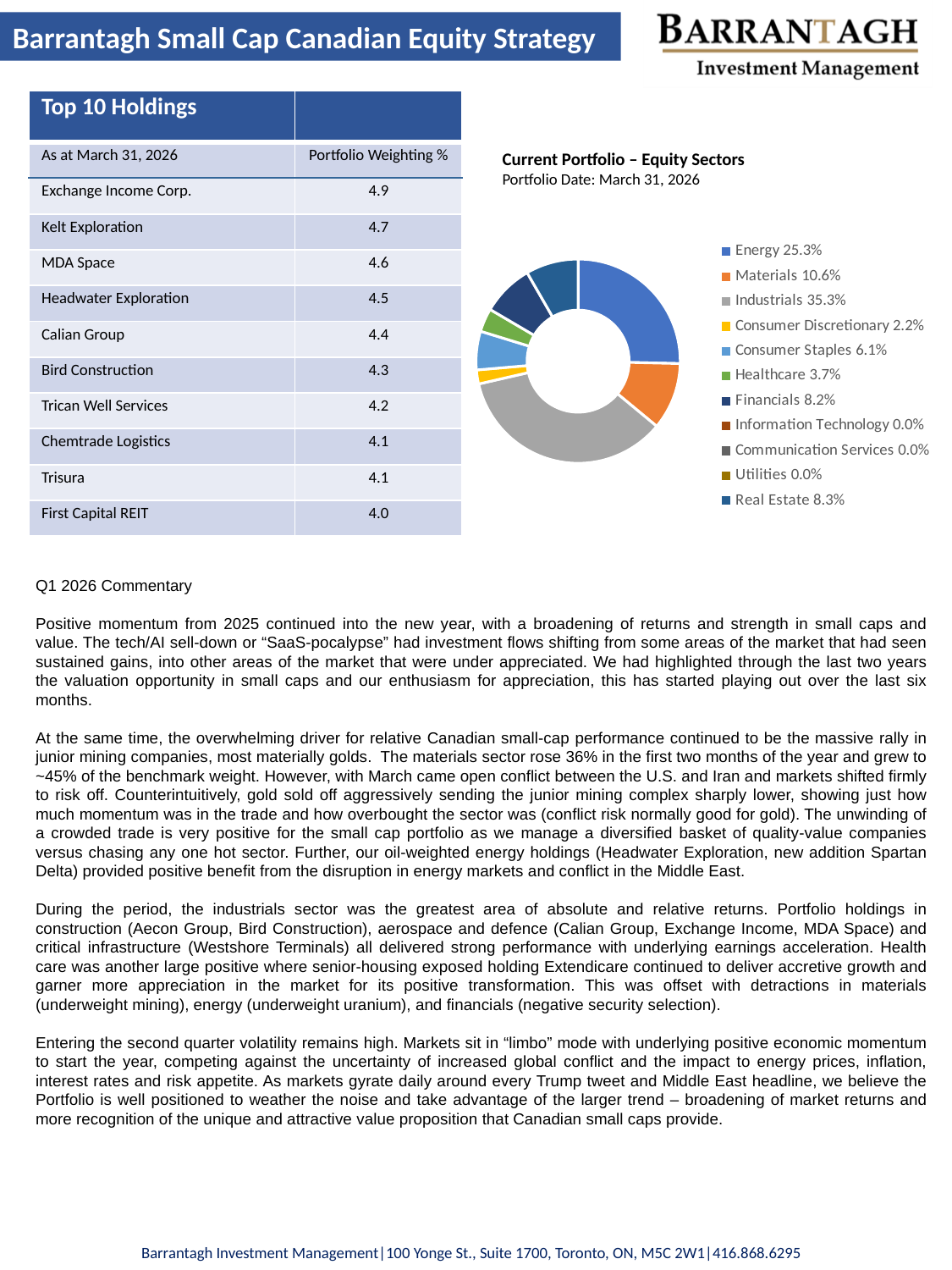
What kind of chart is shown under "Current Portfolio – Equity Sectors"? Doughnut (donut) chart How many sectors are listed in the legend of the Current Portfolio – Equity Sectors chart? 11 In the Current Portfolio – Equity Sectors chart, how many sectors have a weighting of 0.0%? 3 In the Current Portfolio – Equity Sectors chart, which is larger: Energy or Materials? Energy What is the portfolio weighting for Industrials in the Current Portfolio – Equity Sectors chart? 35.3% In the Current Portfolio – Equity Sectors chart, what is the difference between the Industrials and Energy weightings? 10.0% What is the portfolio weighting for Real Estate in the Current Portfolio – Equity Sectors chart? 8.3% In the Current Portfolio – Equity Sectors chart, which is larger: Financials or Real Estate? Real Estate What is the portfolio weighting for Consumer Discretionary in the Current Portfolio – Equity Sectors chart? 2.2% Which sector has the largest share in the Current Portfolio – Equity Sectors chart? Industrials What is the portfolio date shown for the Current Portfolio – Equity Sectors chart? March 31, 2026 What is the portfolio weighting for Energy in the Current Portfolio – Equity Sectors chart? 25.3%